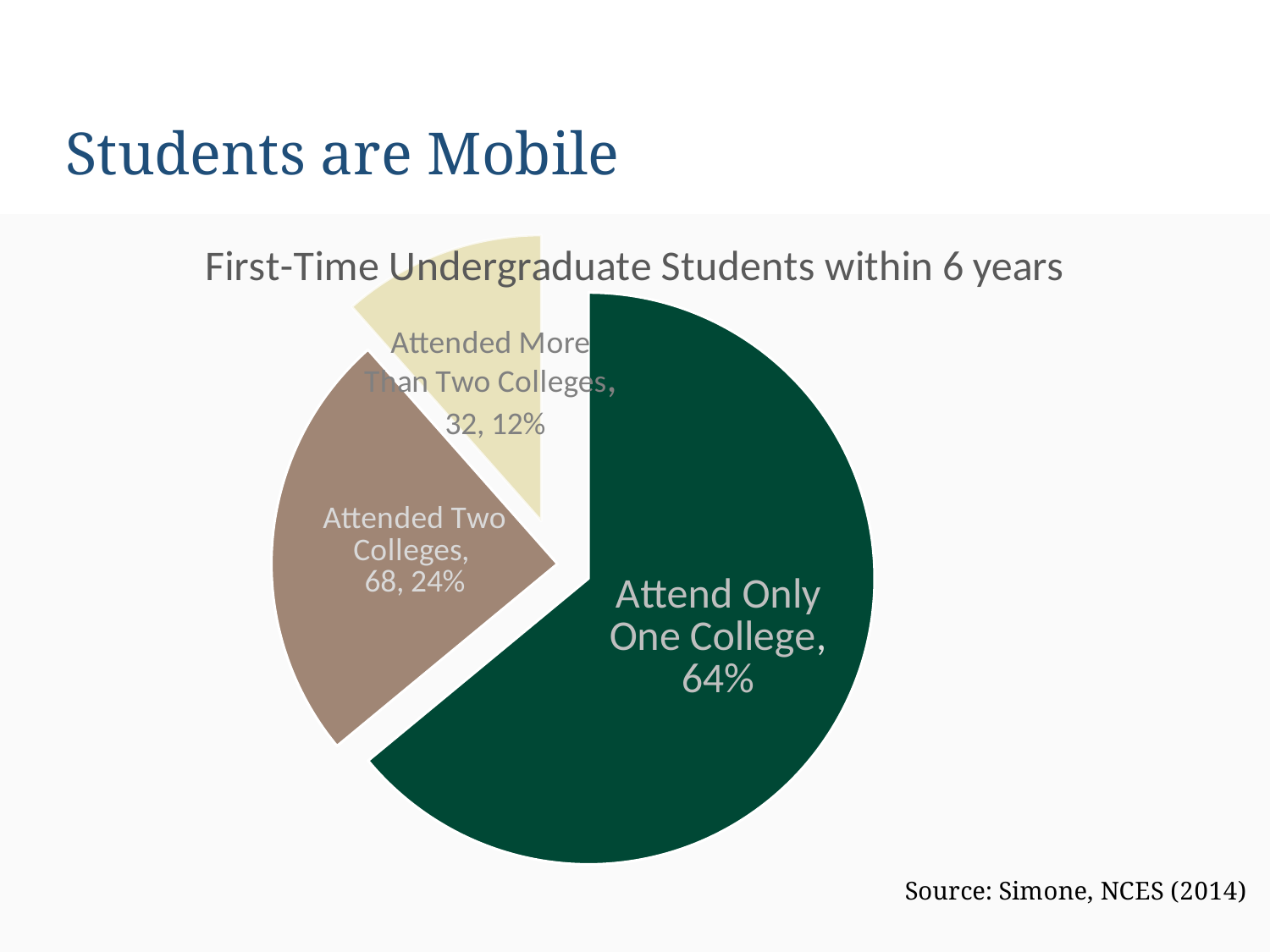
What share of the pie is labelled "Attended Two Colleges"? 24% What is the title of the pie chart? First-Time Undergraduate Students within 6 years What share of the pie is labelled "Attended More Than Two Colleges"? 12% How many slices does the pie chart have? 3 What is the difference in percentage points between the "Attend Only One College" share and the "Attended Two Colleges" share? 40 What count is printed for the "Attended More Than Two Colleges" slice? 32 Which is larger, the share for "Attended Two Colleges" or the share for "Attended More Than Two Colleges"? Attended Two Colleges What kind of chart is shown on the slide? pie chart What share of the pie is labelled "Attend Only One College"? 64% Which slice of the pie is the smallest? Attended More Than Two Colleges What count is printed for the "Attended Two Colleges" slice? 68 Which slice of the pie is the largest? Attend Only One College